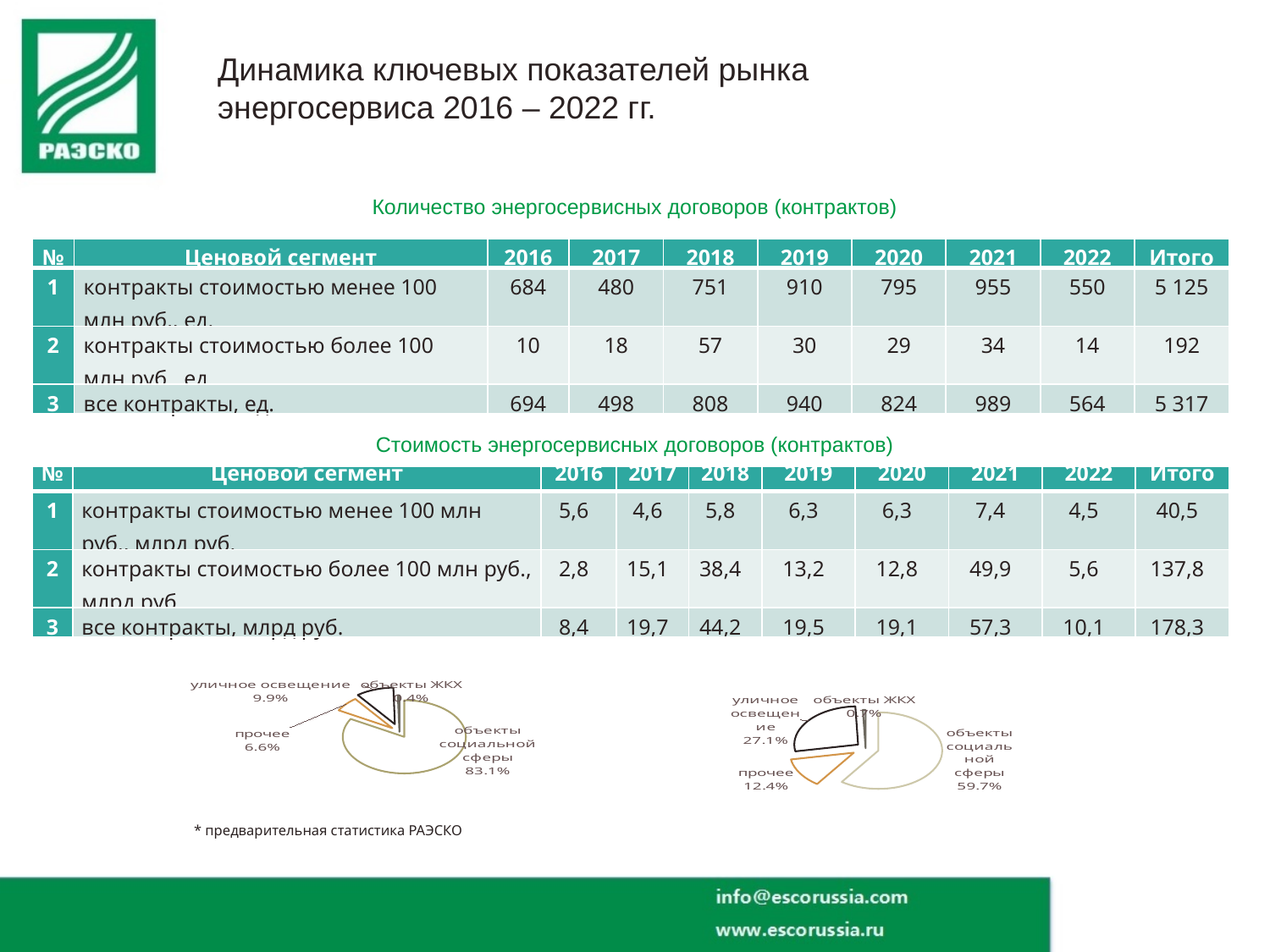
In the left pie chart, what share does 'объекты социальной сферы' have? 83.1% In the left pie chart, what share does 'прочее' have? 6.6% In the right pie chart, what share does 'уличное освещение' have? 27.1% In the left pie chart, which category has the smallest share? объекты ЖКХ In the left pie chart, which category has the largest share? объекты социальной сферы Is the share of 'уличное освещение' larger in the left pie chart or in the right pie chart? right pie chart How many slices does the right pie chart have? 4 In the left pie chart, by how many percentage points does 'объекты социальной сферы' exceed 'уличное освещение'? 73.2 What kind of chart is the left chart at the bottom of the slide? pie chart